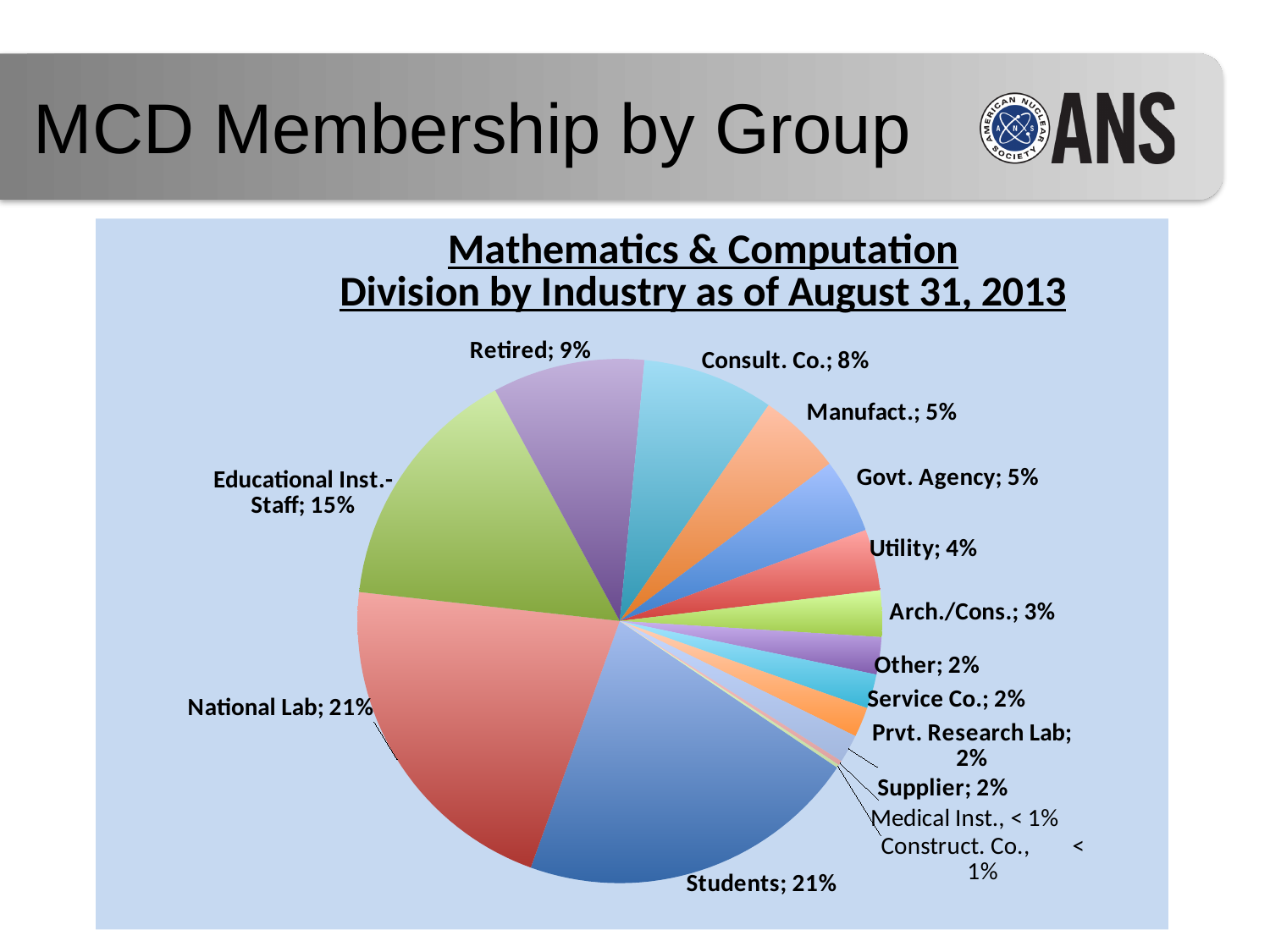
How many categories are shown in the pie chart? 15 What share of the pie does Retired represent? 9% What share of the pie does Students represent? 21% What percentage is shown for Consult. Co.? 8% Which has a larger share, Consult. Co. or Manufact.? Consult. Co. What percentage is shown for Utility? 4% What is the difference in percentage points between National Lab and Govt. Agency? 16% What is the title of the chart? Mathematics & Computation Division by Industry as of August 31, 2013 What percentage is shown for Educational Inst.-Staff? 15% What is the difference in percentage points between Educational Inst.-Staff and Retired? 6% What percentage is shown for Arch./Cons.? 3% What type of chart is shown on the slide? pie chart